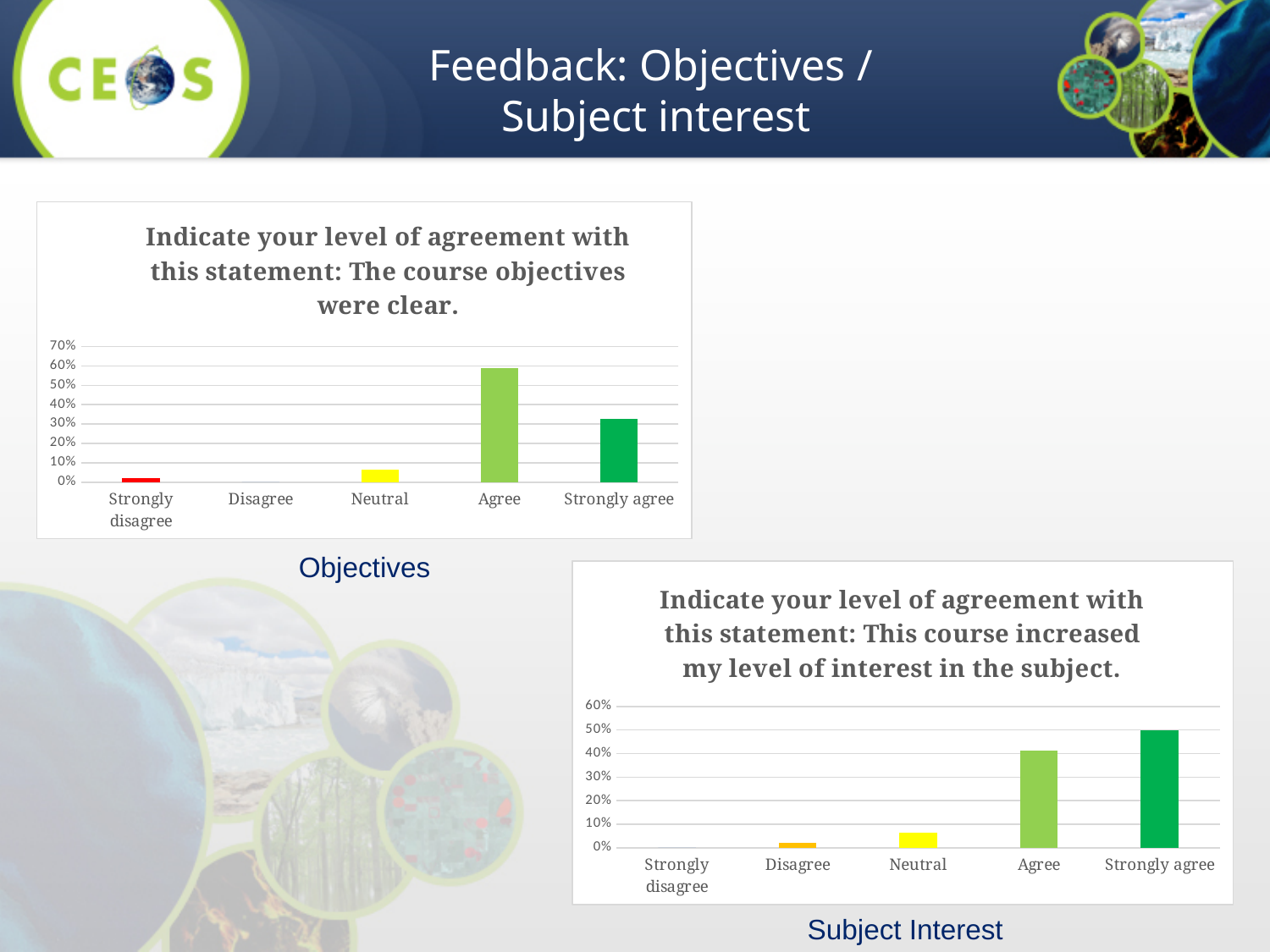
What is the title of the Subject Interest chart? Indicate your level of agreement with this statement: This course increased my level of interest in the subject. How many categories are shown on the x axis of the Objectives chart? 5 In the Subject Interest chart, is the value for Neutral greater or less than 10%? less In the Subject Interest chart, is the value for Agree greater or less than 30%? greater In the Objectives chart, which category has the highest value? Agree In the Subject Interest chart, which category has the highest value? Strongly agree What kind of chart is the Subject Interest chart? bar chart In the Objectives chart, is the value for Strongly agree greater or less than 40%? less In the Subject Interest chart, which is larger, the value for Neutral or the value for Strongly agree? Strongly agree In the Objectives chart, which is larger, the value for Agree or the value for Strongly agree? Agree What is the highest value shown on the y axis of the Objectives chart? 70%